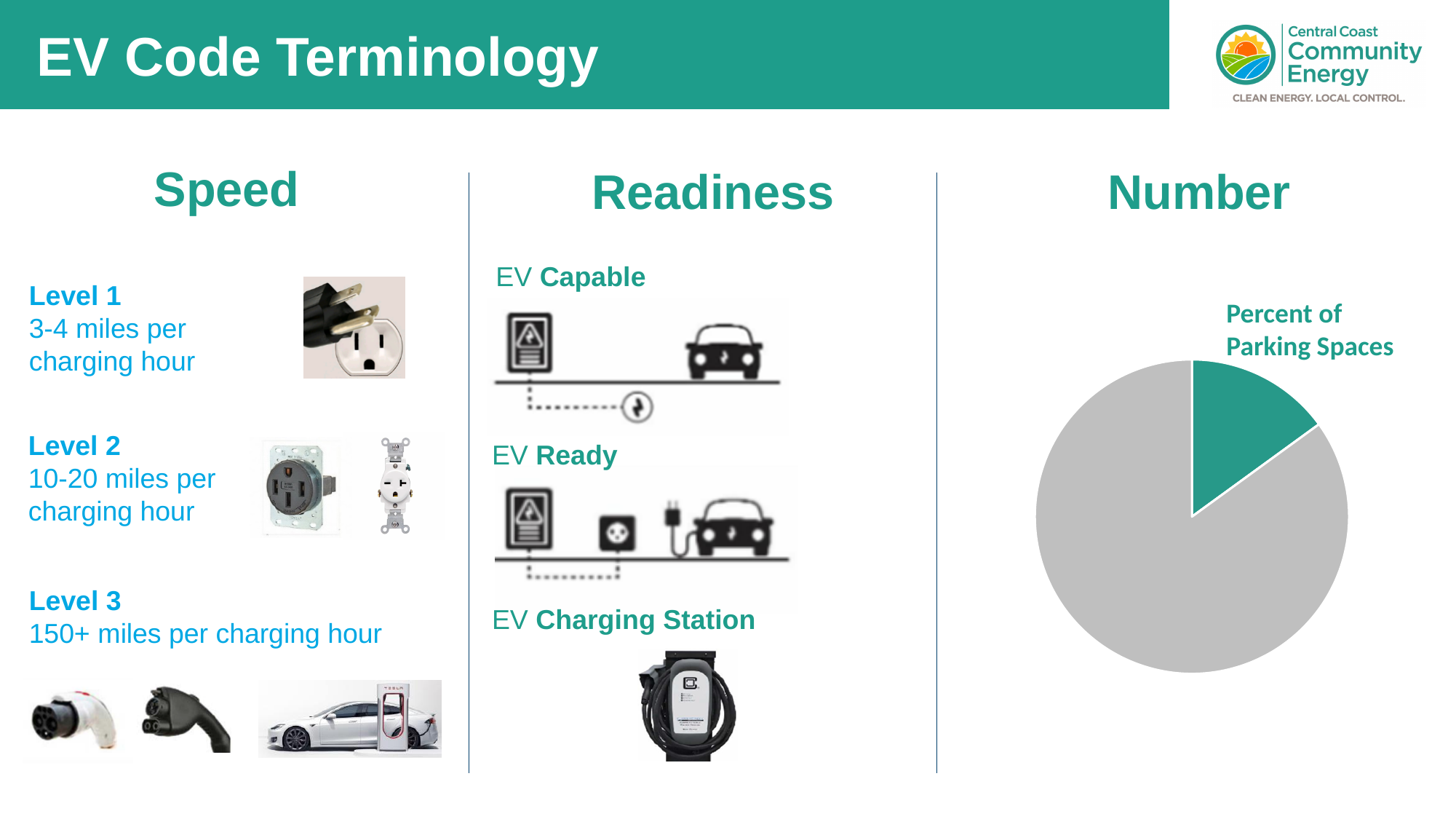
In the "Percent of Parking Spaces" pie chart, which slice is larger, the teal slice or the gray slice? the gray slice What colour is the smaller slice of the "Percent of Parking Spaces" pie chart? teal How many slices does the "Percent of Parking Spaces" pie chart have? 2 What kind of chart is shown under the "Number" heading? pie chart In the "Percent of Parking Spaces" pie chart, which slice is the smallest? the teal slice What is the title of the pie chart on the slide? Percent of Parking Spaces